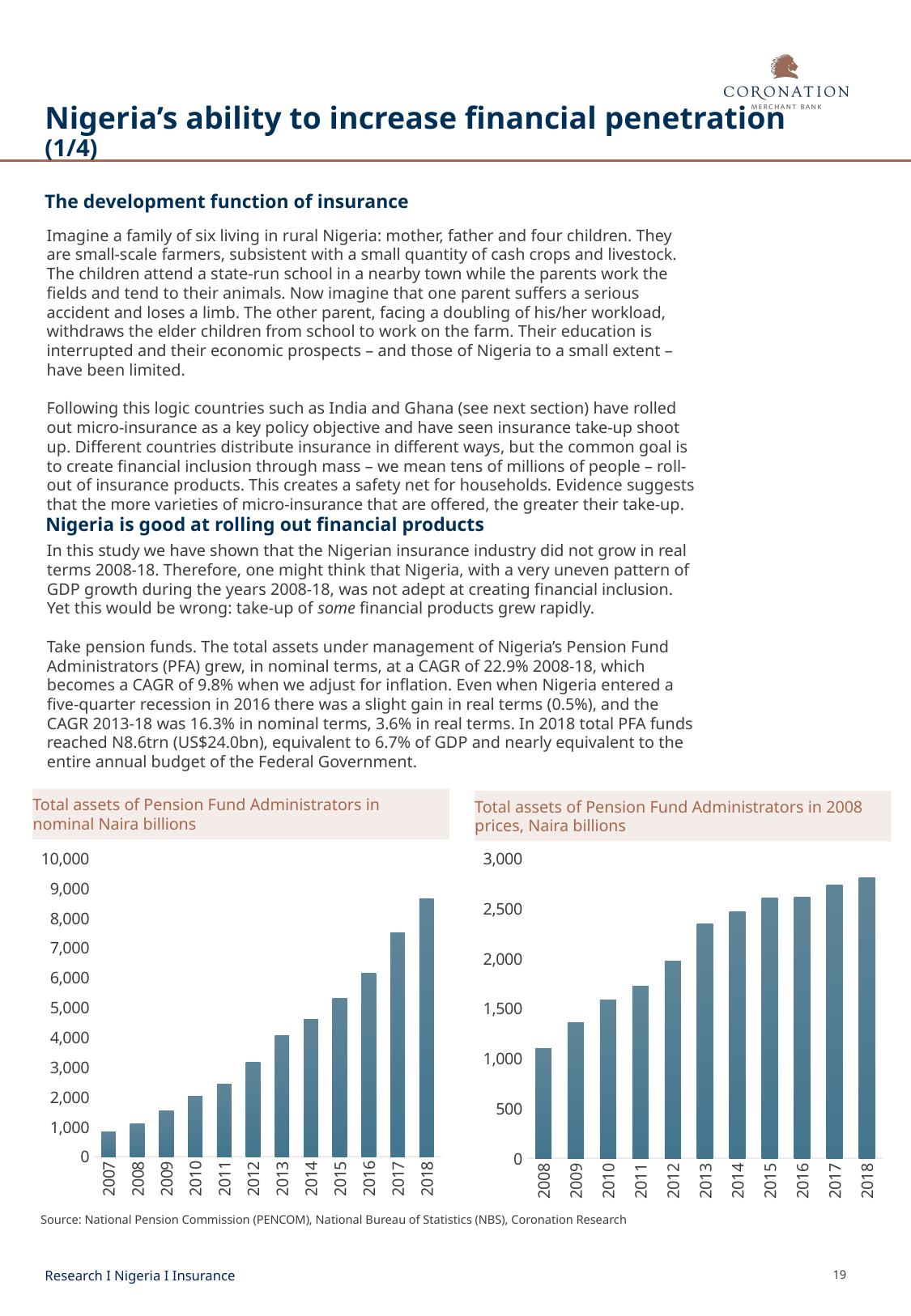
In the right chart (2008 prices), is the value for 2018 greater or less than 3,000? less How many years are shown in the right chart (2008 prices)? 11 How many years are shown in the left chart (nominal Naira billions)? 12 In the left chart (nominal Naira billions), which year has the lowest value? 2007 In the left chart (Total assets of Pension Fund Administrators in nominal Naira billions), which year has the highest value? 2018 In the left chart (nominal Naira billions), is the value for 2007 greater or less than 1,000? less In the left chart (nominal Naira billions), is the value for 2018 greater or less than 8,000? greater What kind of chart is the right chart (2008 prices, Naira billions)? Bar chart In the right chart (Total assets of Pension Fund Administrators in 2008 prices, Naira billions), which year has the highest value? 2018 In the right chart (2008 prices), which year has the lowest value? 2008